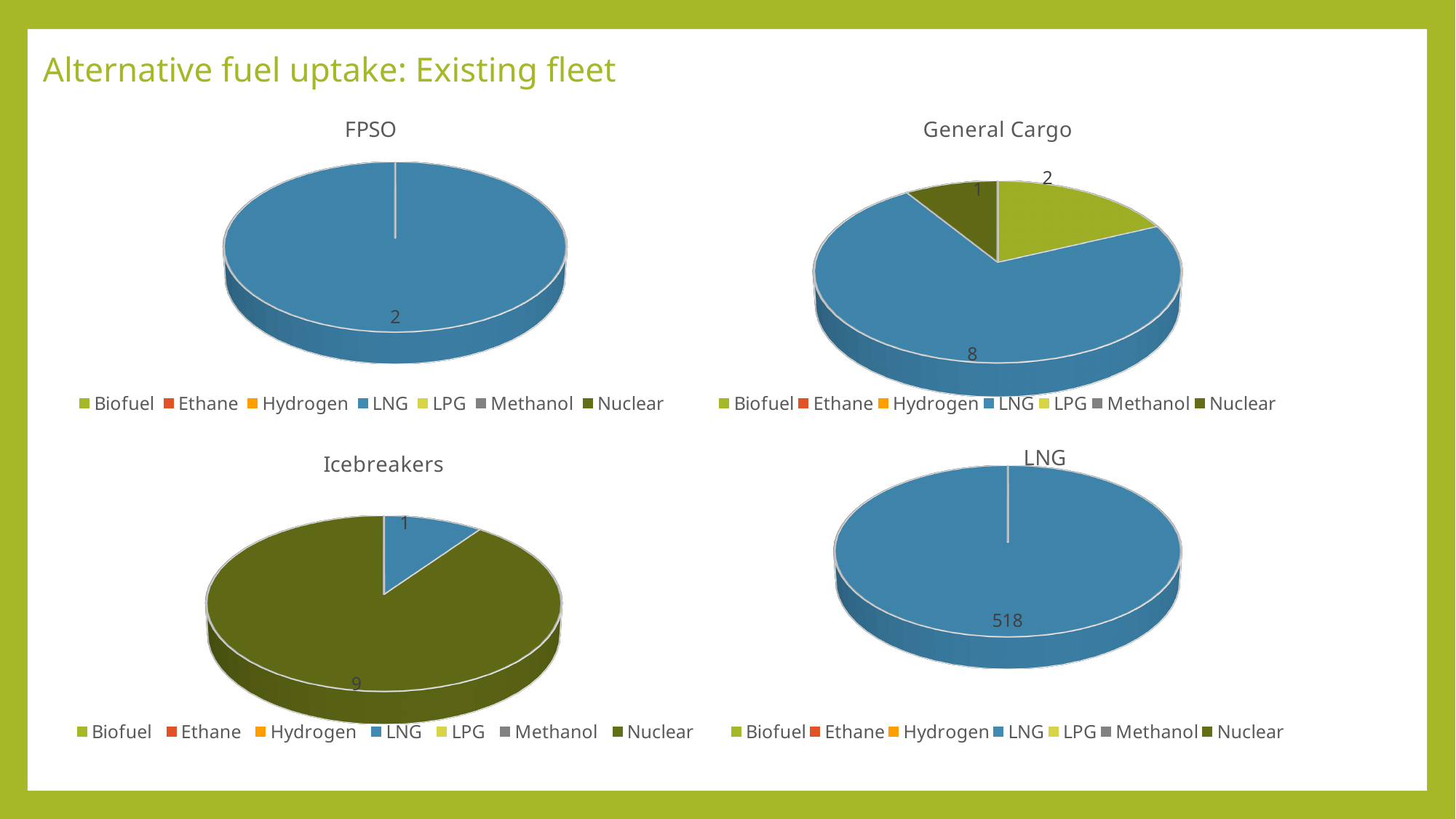
In the General Cargo chart, what is the value for Nuclear? 1 What kind of chart is the FPSO chart? pie chart How many pie charts are shown on the slide? 4 How many entries does the legend of the Icebreakers chart list? 7 In the Icebreakers chart, what is the value for Nuclear? 9 In the FPSO chart, what is the value for LNG? 2 In the LNG chart, what is the value for LNG? 518 In the Icebreakers chart, which is larger, Nuclear or LNG? Nuclear In the Icebreakers chart, what is the value for LNG? 1 In the General Cargo chart, which fuel has the largest slice? LNG In the General Cargo chart, what is the value for LNG? 8 In the General Cargo chart, what is the difference between the LNG value and the Nuclear value? 7